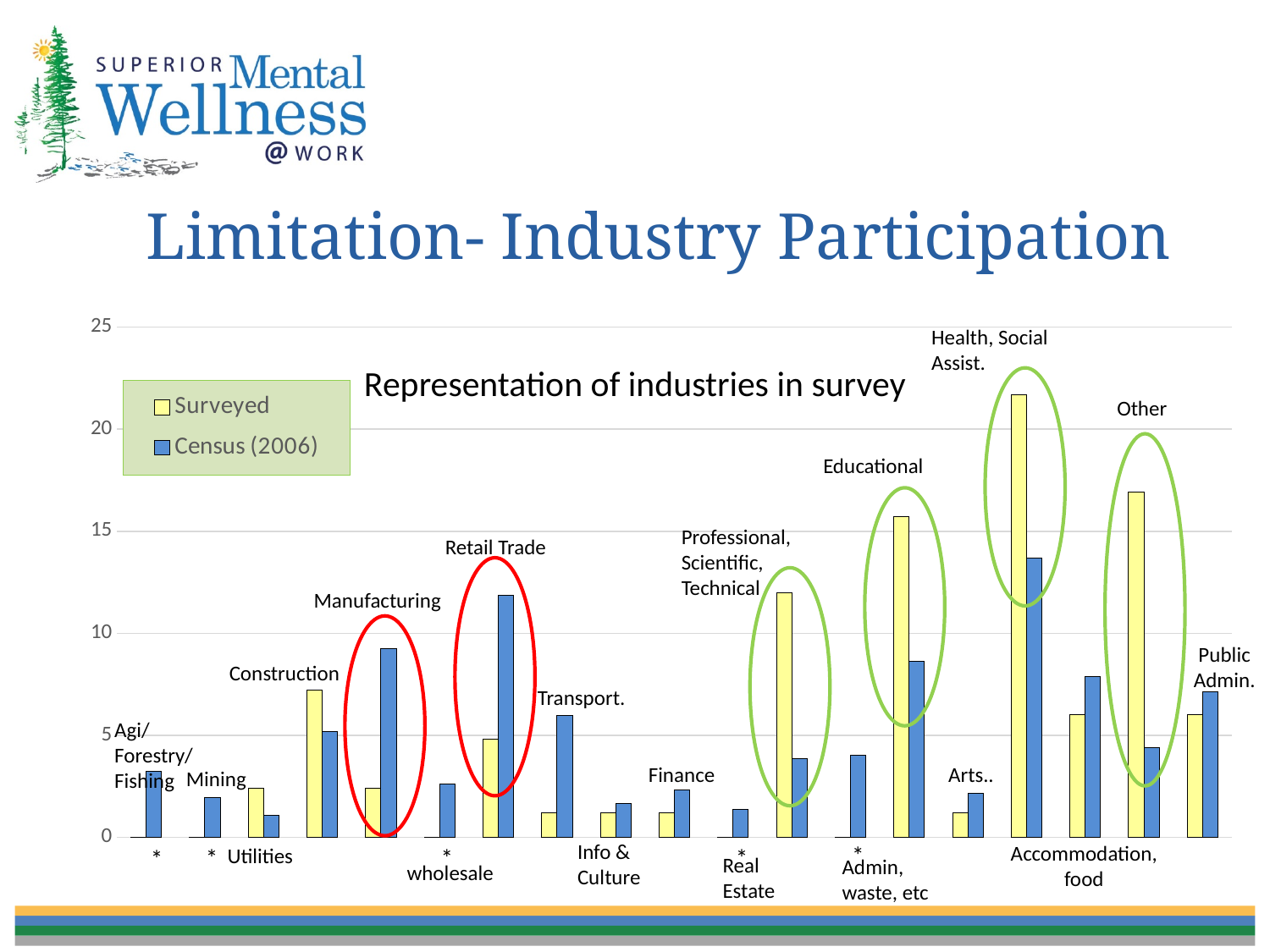
Is the Surveyed value for Other greater or less than 15? greater What kind of chart is shown on the slide? bar chart What are the two series named in the chart legend? Surveyed and Census (2006) Which industry has the highest Census (2006) value? Health, Social Assist. How many series does the chart legend list? 2 For Manufacturing, which is larger: the Surveyed value or the Census (2006) value? Census (2006) What is the title of the chart? Representation of industries in survey Is the Census (2006) value for Accommodation, food greater or less than 5? greater Is the Surveyed value for Health, Social Assist. greater or less than 20? greater Which industry has the highest Surveyed value? Health, Social Assist. For Professional, Scientific, Technical, which is larger: the Surveyed value or the Census (2006) value? Surveyed